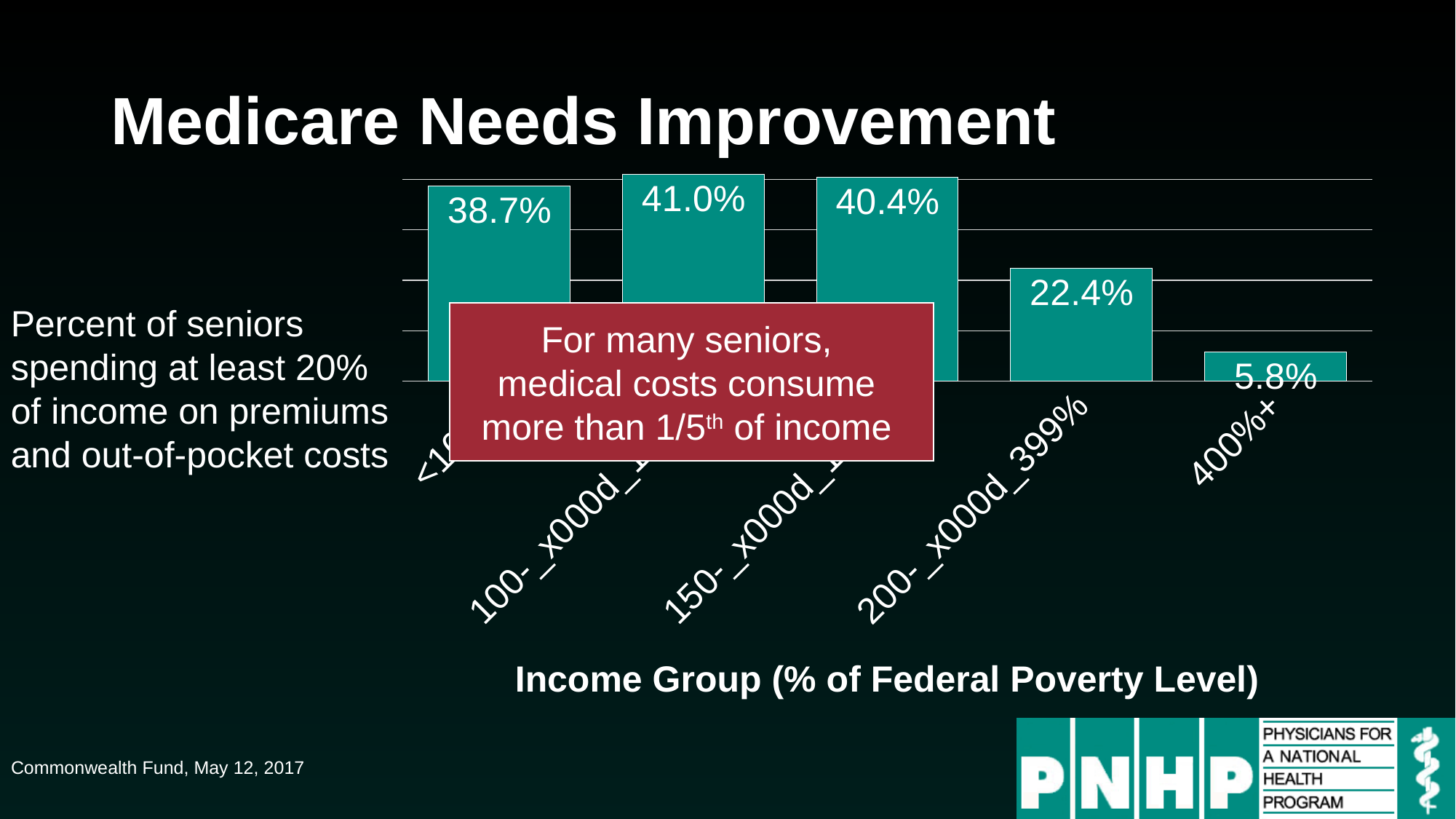
What is the value shown on the first (leftmost) bar of the chart? 38.7% What is the difference between the values for the 200-399% group and the 400%+ group? 16.6% What is the value shown on the third bar from the left? 40.4% What is the x-axis title of the chart? Income Group (% of Federal Poverty Level) What is the value shown on the second bar from the left? 41.0% How many bars are plotted in the chart? 5 Which income group has the lowest value in the chart? 400%+ What is the value shown for the 200-399% income group? 22.4% Which is larger: the value for the 200-399% group or the value for the 400%+ group? 200-399% What type of chart is shown on the slide? bar chart What is the value shown for the 400%+ income group? 5.8% What is the highest value shown in the chart? 41.0%